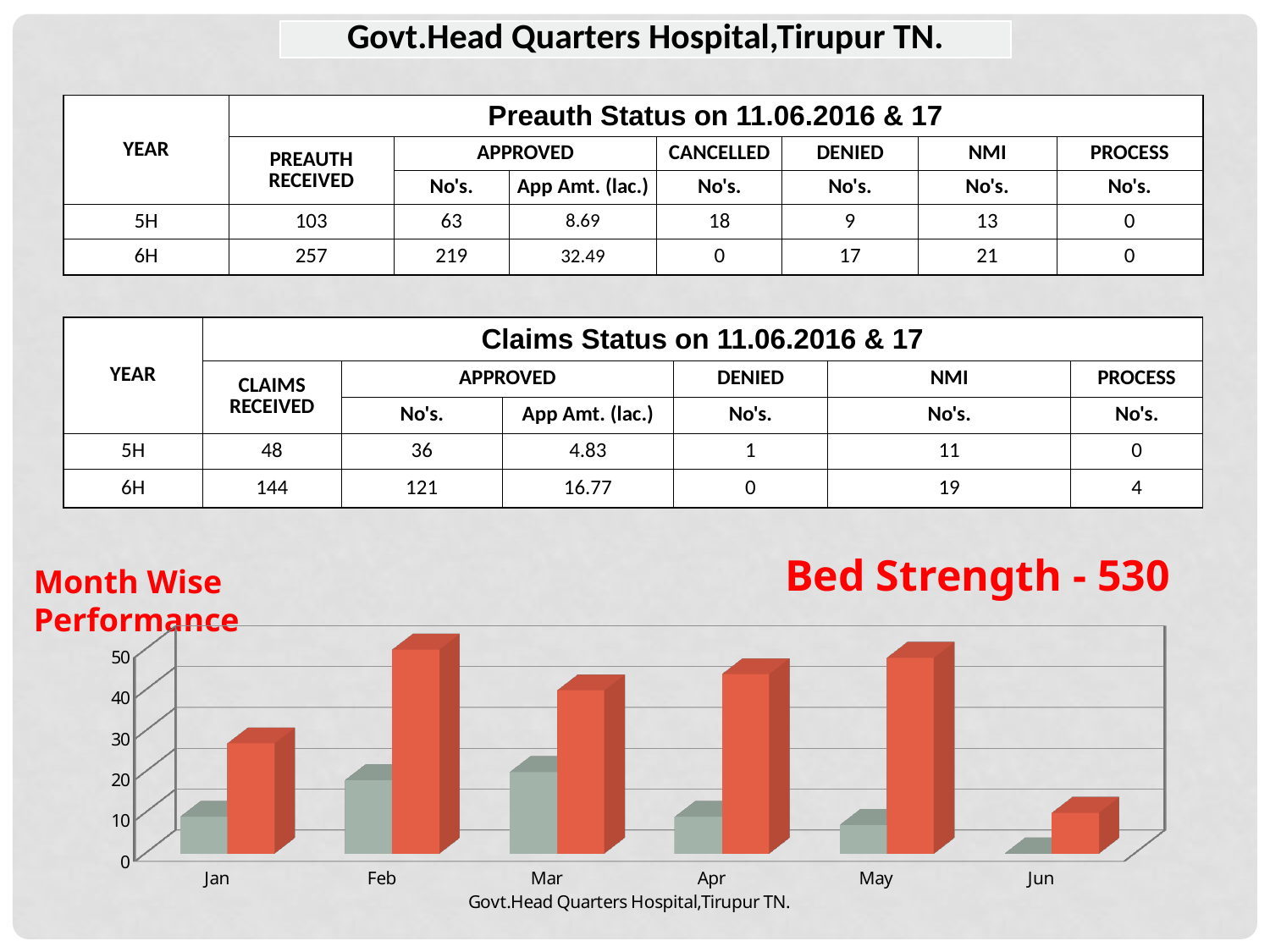
What text appears below the x axis of the chart? Govt.Head Quarters Hospital,Tirupur TN. Which is larger in the chart, the grey bar for Mar or the grey bar for Jun? Mar Is the grey bar for Jun greater or less than 10? less Which month has the lowest red bar in the chart? Jun Is the grey bar for Mar greater or less than 10? greater Is the red bar for Feb greater or less than 40? greater Which is larger in the chart, the red bar for Feb or the red bar for Jan? Feb Which month has the lowest grey bar in the chart? Jun What kind of chart is shown at the bottom of the slide? bar chart How many months are shown on the x axis of the chart? 6